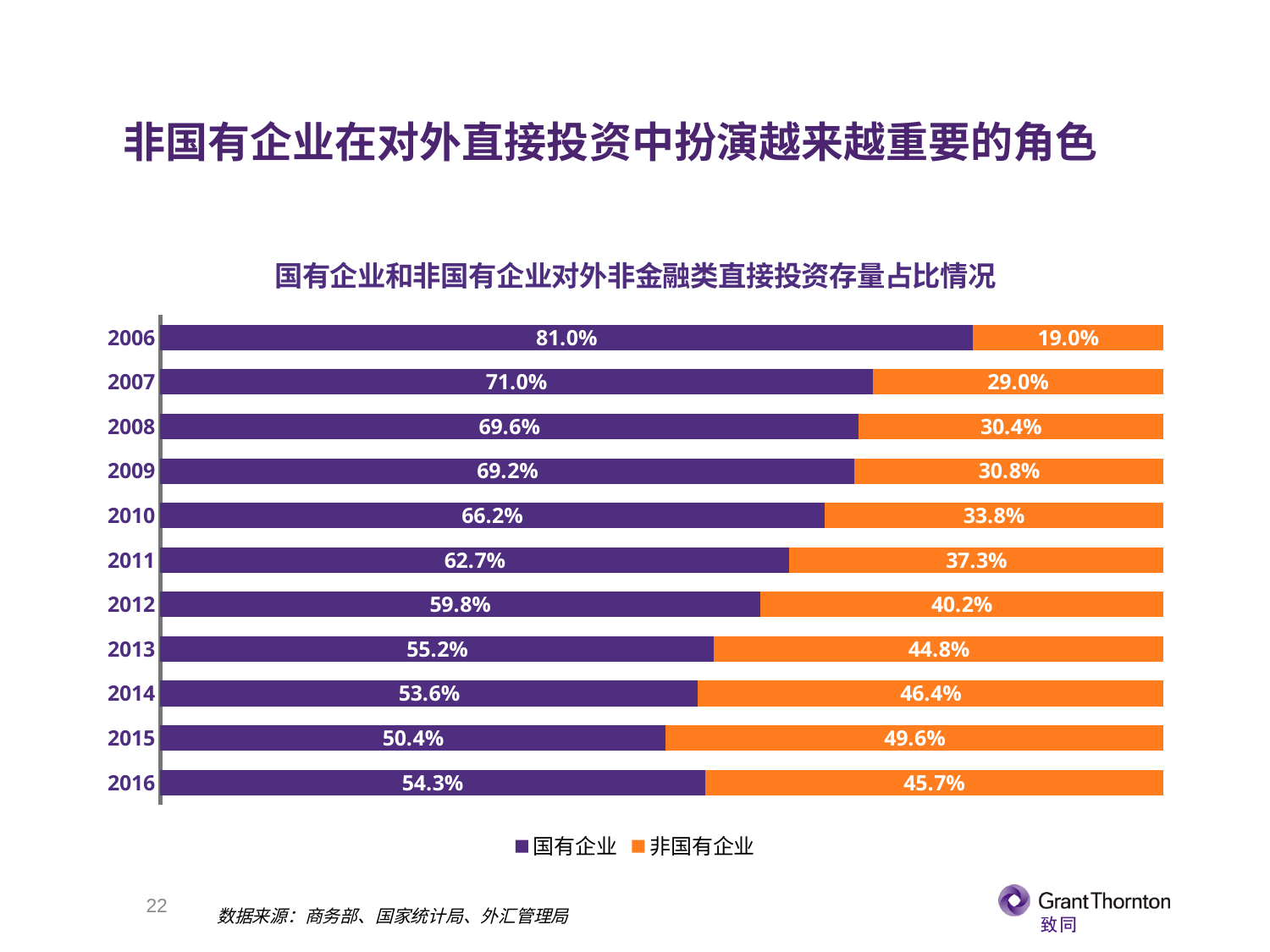
In which year is the 国有企业 share lowest? 2015 Does the 非国有企业 share generally rise or fall from 2006 to 2015? Rise What is the value for 非国有企业 in 2016? 45.7% What is the difference between the 国有企业 share in 2006 and in 2016? 26.7% What kind of chart is shown on the slide? Stacked bar chart What is the total of the stacked bar for 2010? 100.0% What is the value for 非国有企业 in 2012? 40.2% How many years are shown on the chart? 11 How many series does the legend list? 2 In which year is the 非国有企业 share highest? 2015 Which is larger in 2014: the 国有企业 share or the 非国有企业 share? 国有企业 What is the value for 国有企业 in 2006? 81.0%